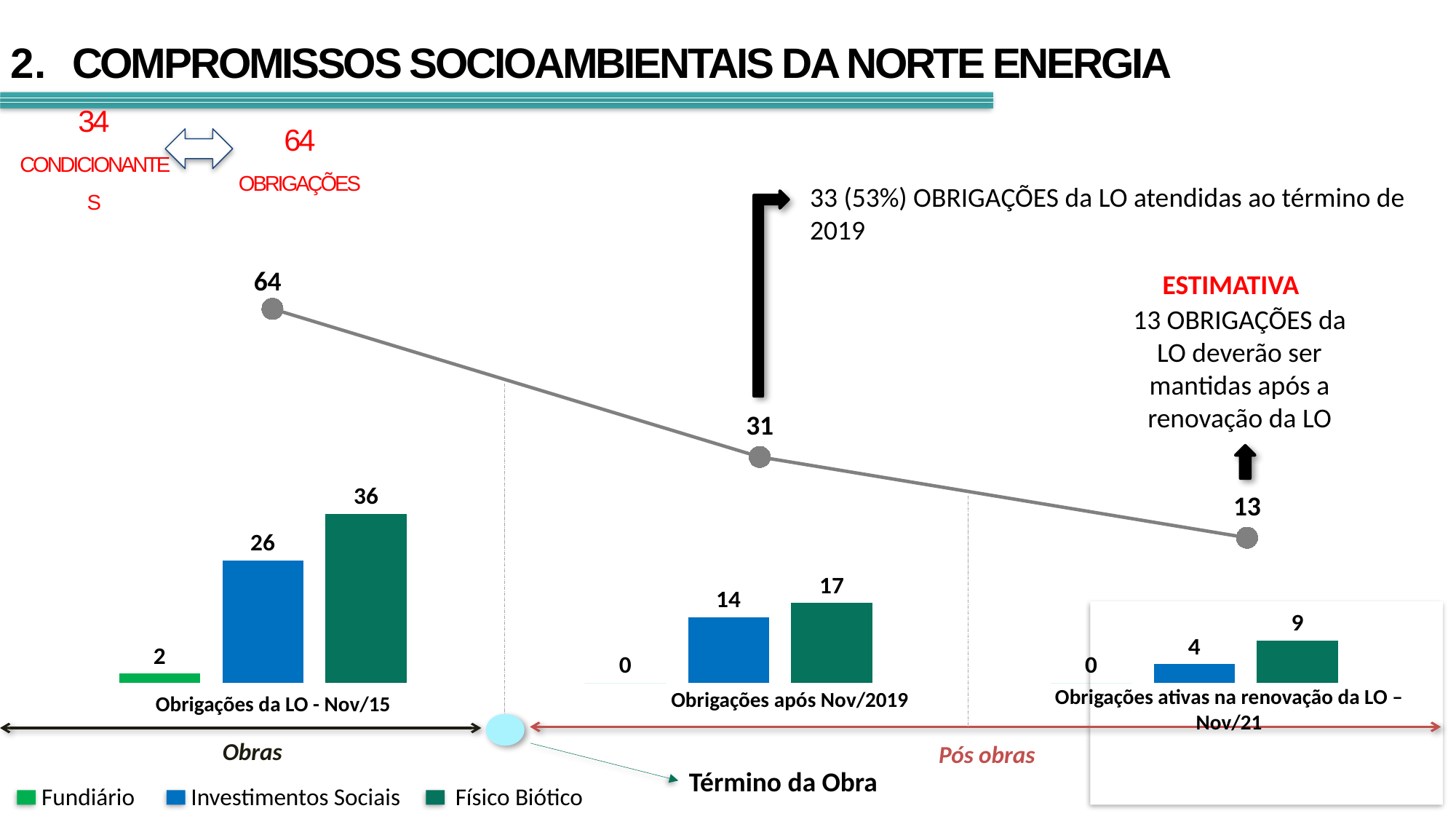
What is the value for Fundiário in the 'Obrigações da LO - Nov/15' group? 2 What is the value of the line at 'Obrigações ativas na renovação da LO – Nov/21'? 13 What is the difference between the Físico Biótico and Investimentos Sociais values in the 'Obrigações após Nov/2019' group? 3 What is the difference between the line values at 'Obrigações da LO - Nov/15' and 'Obrigações após Nov/2019'? 33 Which is larger in the 'Obrigações ativas na renovação da LO – Nov/21' group: Investimentos Sociais or Físico Biótico? Físico Biótico Which group has the highest value for Físico Biótico? Obrigações da LO - Nov/15 What is the value for Investimentos Sociais in the 'Obrigações após Nov/2019' group? 14 What is the value for Físico Biótico in the 'Obrigações da LO - Nov/15' group? 36 Which group has the lowest value for Investimentos Sociais? Obrigações ativas na renovação da LO – Nov/21 How many groups of bars are shown on the chart? 3 Does the line value rise or fall from 'Obrigações da LO - Nov/15' to 'Obrigações ativas na renovação da LO – Nov/21'? fall How many series does the legend list? 3